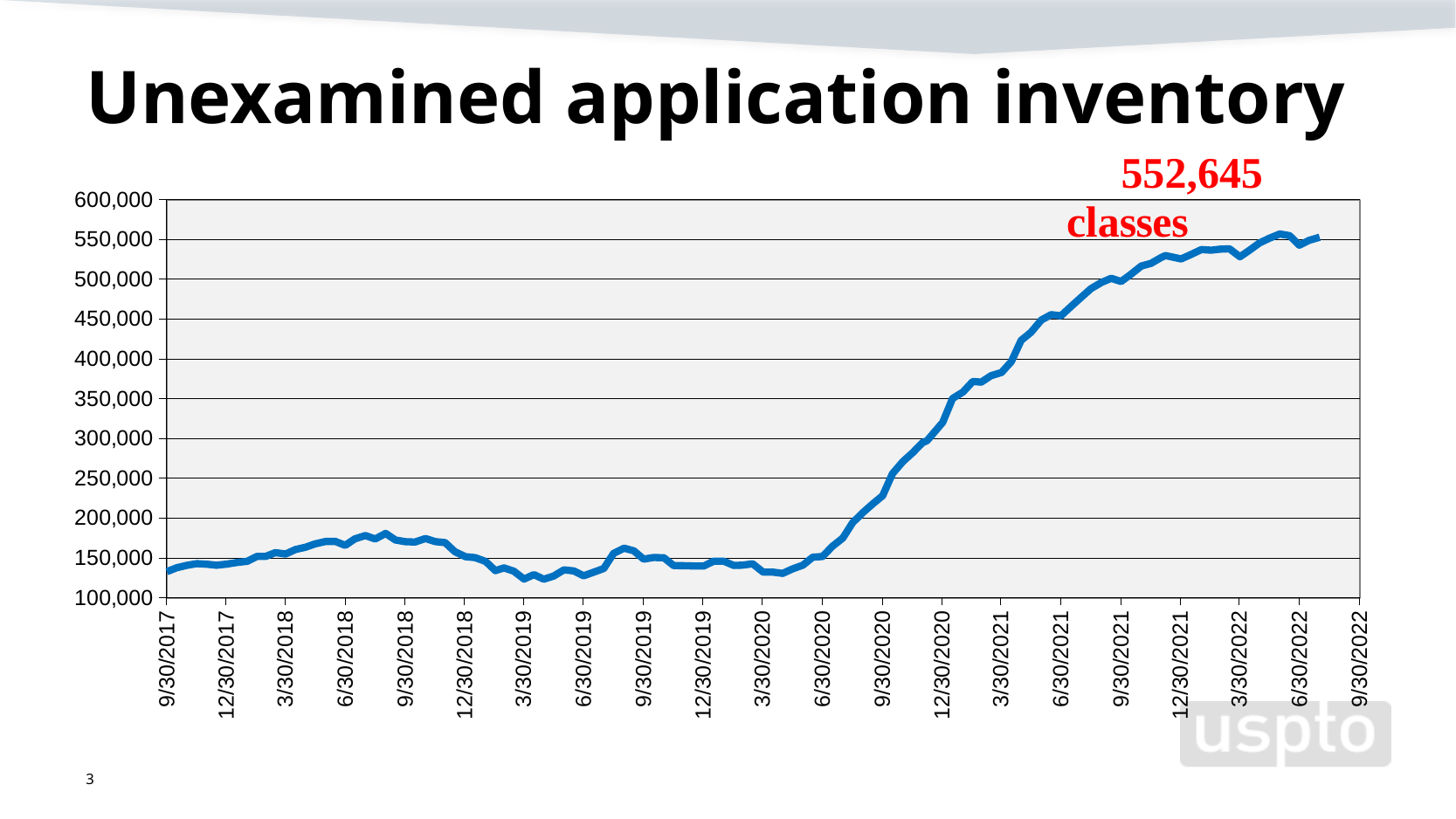
Does the line generally rise or fall between 6/30/2020 and 6/30/2022? rise Is the value at 9/30/2020 greater or less than 200,000? greater What is the most recent inventory value annotated on the chart? 552,645 classes Is the value at 12/30/2021 greater or less than 500,000? greater What is the title of the chart? Unexamined application inventory Is the value at 3/30/2021 greater or less than 350,000? greater In which year does the line reach its highest point? 2022 In which year does the line reach its lowest point? 2019 What kind of chart is shown on the slide? line chart Which is larger, the value at 6/30/2022 or the value at 9/30/2017? 6/30/2022